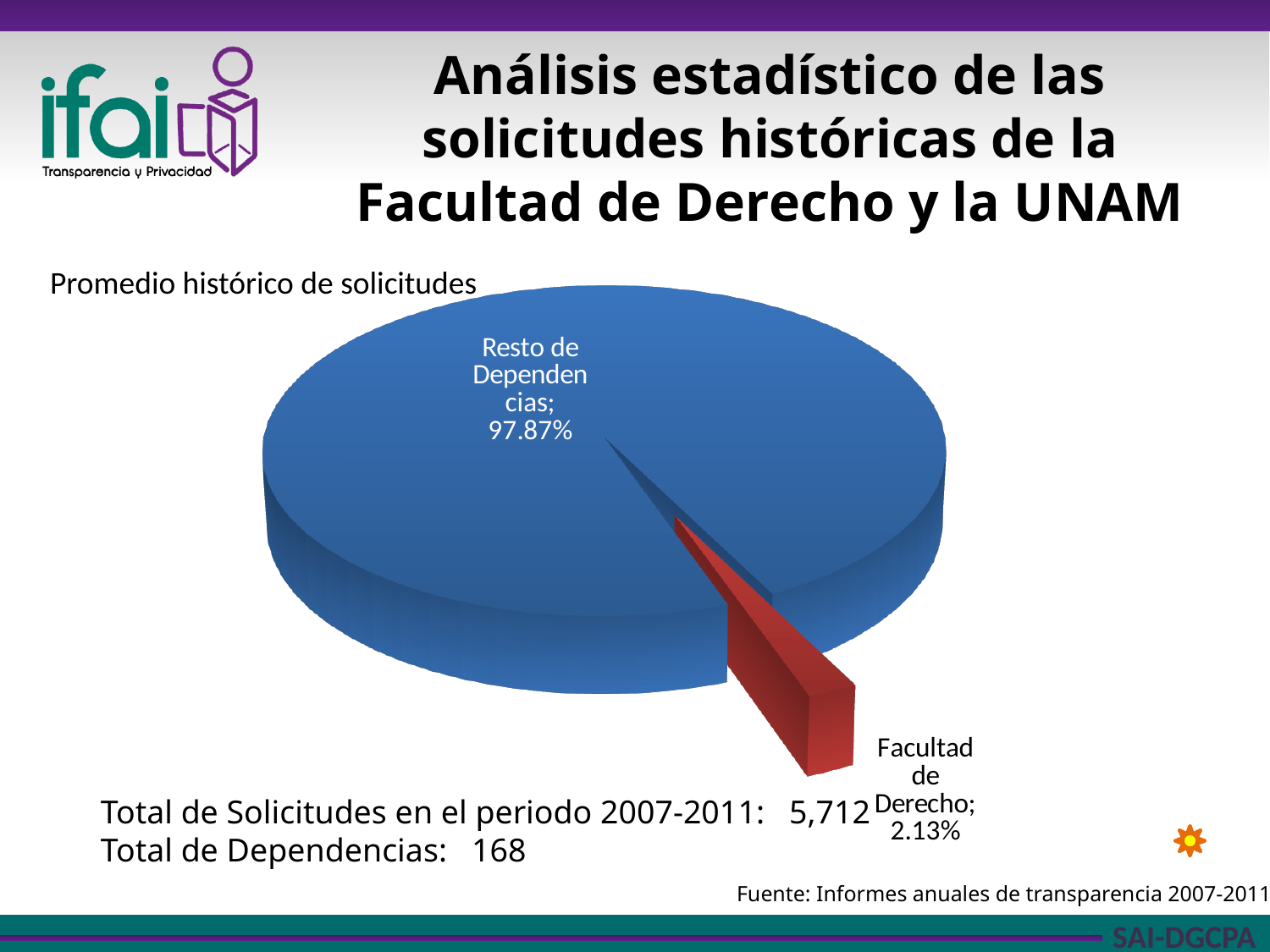
What share of the pie does "Facultad de Derecho" represent? 2.13% Which is larger, the share for "Facultad de Derecho" or the share for "Resto de Dependencias"? Resto de Dependencias What is the title of the chart? Promedio histórico de solicitudes Which slice of the pie is the smallest? Facultad de Derecho What share of the pie does "Resto de Dependencias" represent? 97.87% What is the difference in percentage points between the "Resto de Dependencias" slice and the "Facultad de Derecho" slice? 95.74 What kind of chart is shown on the slide? Pie chart What colour is the "Facultad de Derecho" slice? Red Which slice of the pie is the largest? Resto de Dependencias How many slices does the pie chart have? 2